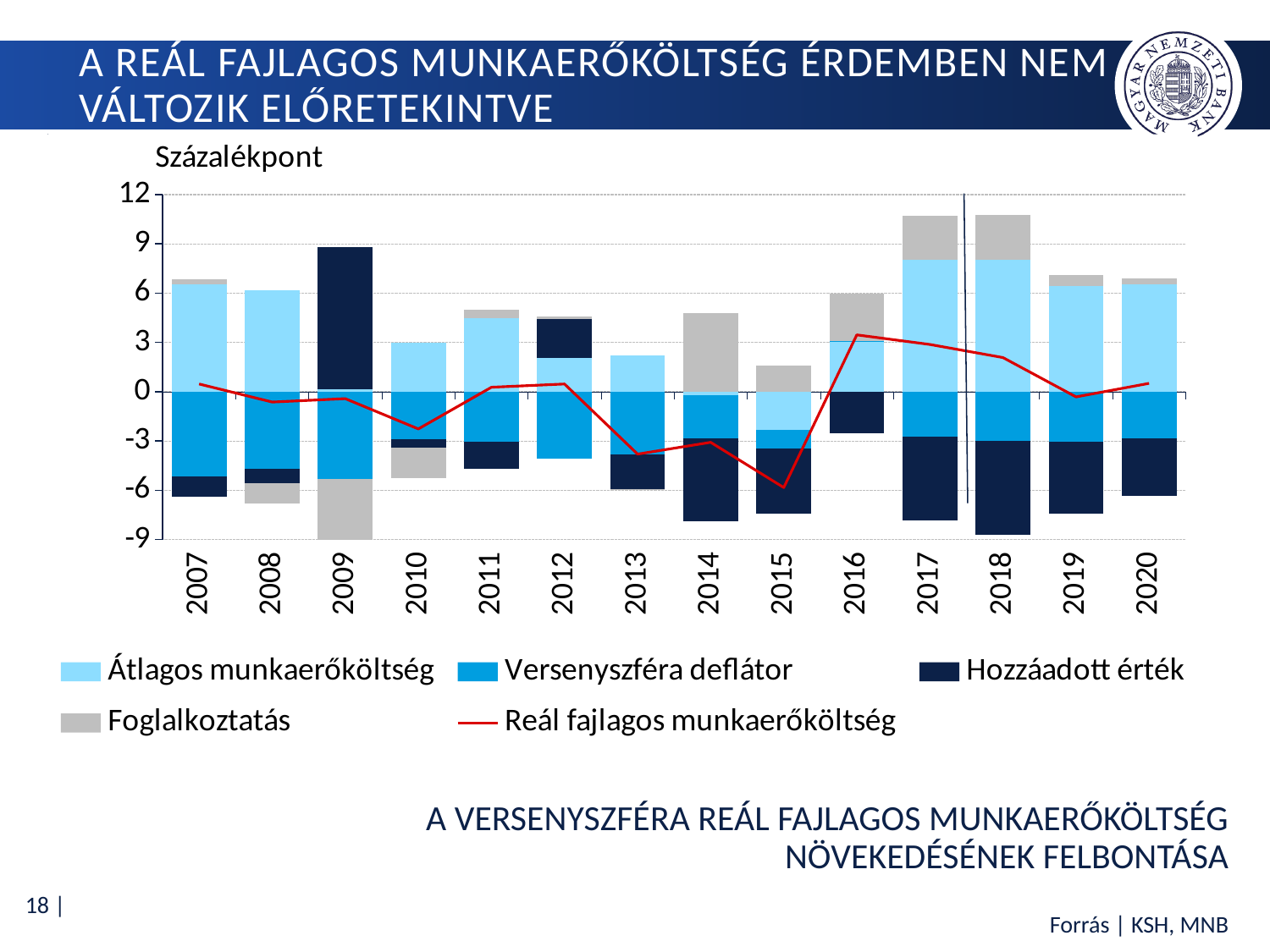
How many series does the chart legend list? 5 Which series is drawn as a red line in the chart? Reál fajlagos munkaerőköltség Does the Reál fajlagos munkaerőköltség line rise or fall from 2013 to 2015? fall Is the Átlagos munkaerőköltség bar segment in 2017 greater or less than 6? greater Which year has the larger Átlagos munkaerőköltség bar segment, 2013 or 2017? 2017 Is the value of the Reál fajlagos munkaerőköltség line in 2016 greater or less than 0? greater Is the Hozzáadott érték bar segment in 2009 greater or less than 6? greater In which year is the Reál fajlagos munkaerőköltség line at its lowest? 2015 How many years are shown on the x axis of the chart? 14 What kind of chart is shown on the slide? A stacked bar chart with a line What unit is shown above the y axis of the chart? Százalékpont